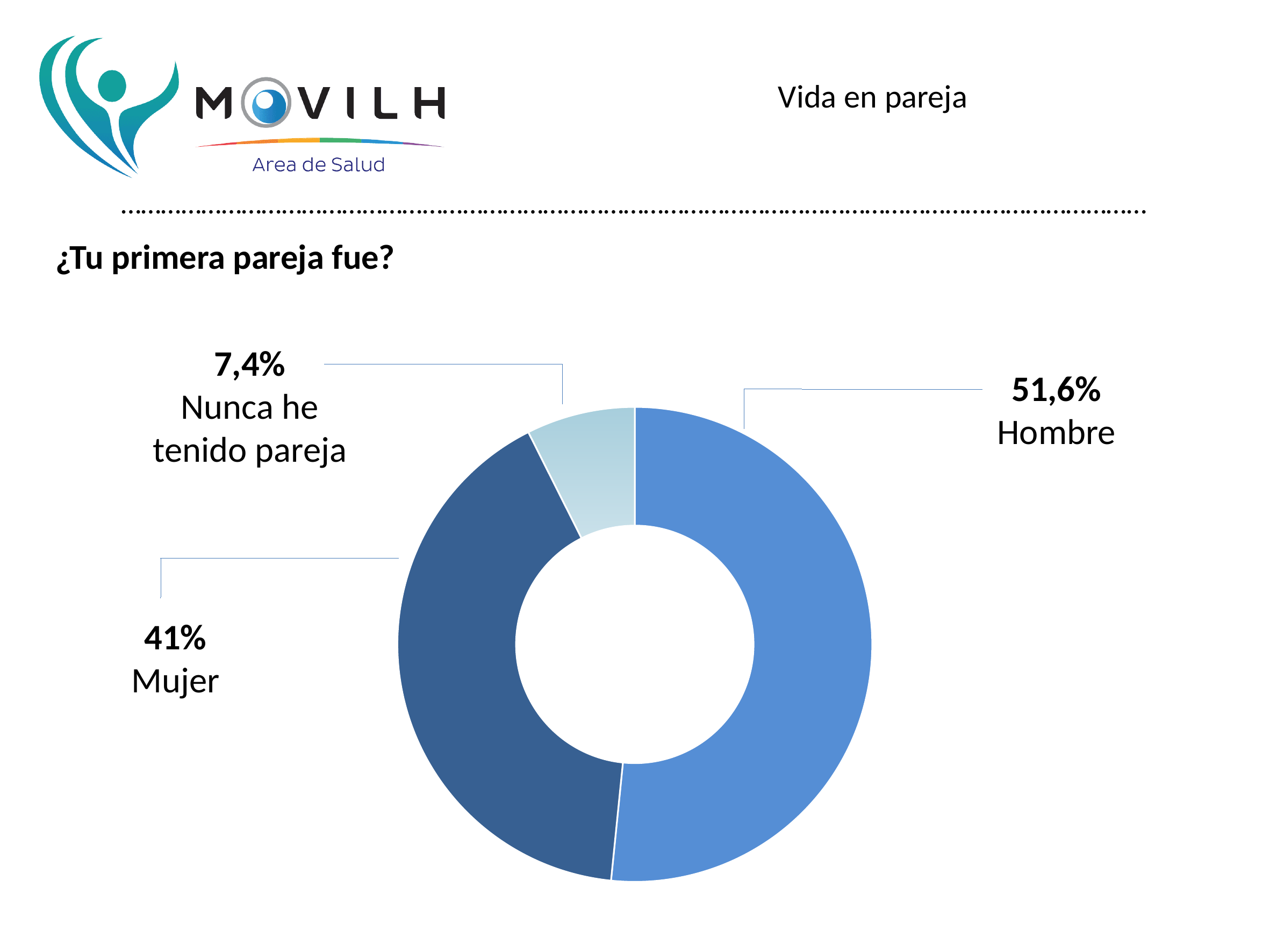
Which category has the largest share of the chart? Hombre Which is larger, the share for "Hombre" or the share for "Mujer"? Hombre What question does the chart answer, as written above it? ¿Tu primera pareja fue? What percentage of respondents answered "Nunca he tenido pareja"? 7,4% What is the difference in percentage points between "Mujer" and "Nunca he tenido pareja"? 33,6 Which category is shown in the lightest colour on the chart? Nunca he tenido pareja How many categories are shown in the chart? 3 What kind of chart is shown on the slide? Pie chart (doughnut) What percentage of respondents answered "Mujer"? 41% What percentage of respondents answered "Hombre" to "¿Tu primera pareja fue?"? 51,6% What is the difference in percentage points between "Hombre" and "Mujer"? 10,6 Which category has the smallest share of the chart? Nunca he tenido pareja